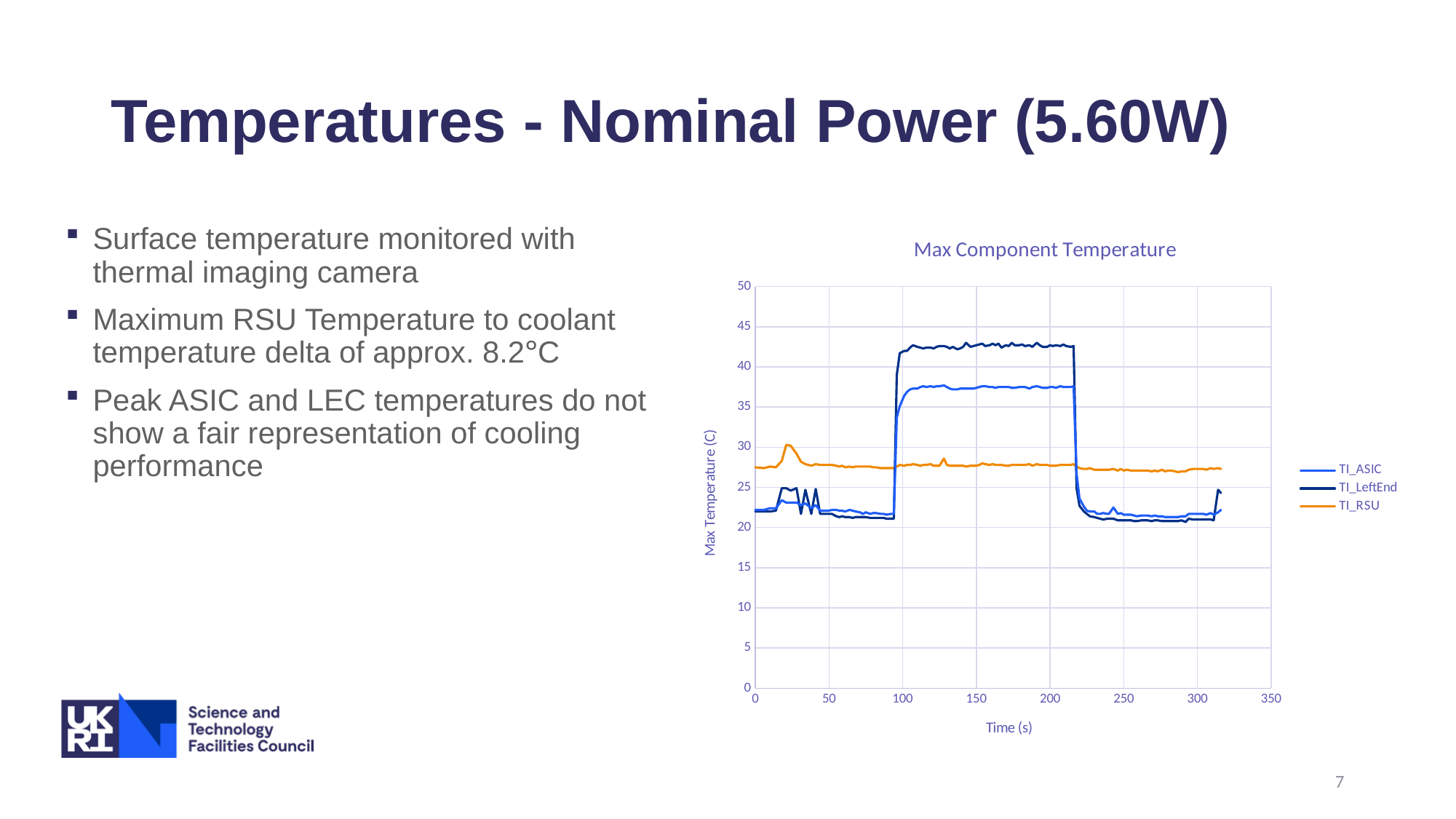
At 150 s, which series is higher, TI_ASIC or TI_LeftEnd? TI_LeftEnd What is the title of the chart? Max Component Temperature At 150 s, which series is higher, TI_RSU or TI_ASIC? TI_ASIC Is the value for TI_ASIC at 250 s greater or less than 25? less Is the value for TI_LeftEnd at 150 s greater or less than 40? greater Is the value for TI_RSU at 150 s greater or less than 30? less What kind of chart is shown on the slide? line chart What is the label of the x axis of the chart? Time (s) Which series reaches the highest temperature between 100 s and 200 s? TI_LeftEnd How many series does the legend of the chart list? 3 Which series has the lowest temperature between 100 s and 200 s? TI_RSU